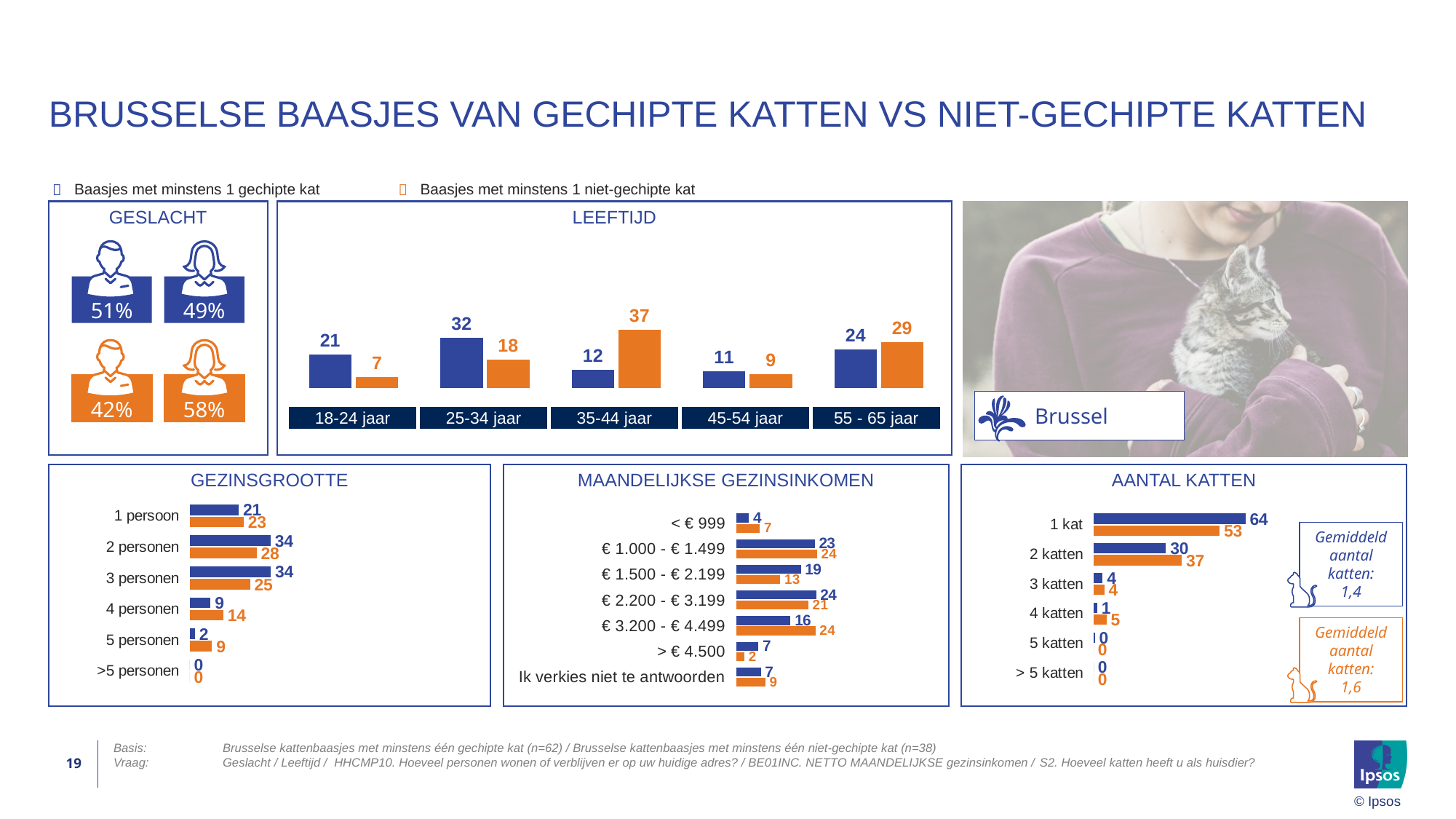
In the AANTAL KATTEN chart, what is the difference between the two series for 2 katten? 7 In the MAANDELIJKSE GEZINSINKOMEN chart, which is larger for > € 4.500: Baasjes met minstens 1 gechipte kat or Baasjes met minstens 1 niet-gechipte kat? Baasjes met minstens 1 gechipte kat In the MAANDELIJKSE GEZINSINKOMEN chart, what is the value for € 1.500 - € 2.199 for Baasjes met minstens 1 gechipte kat? 19 How many series does the legend at the top of the slide list? 2 In the GEZINSGROOTTE chart, which category has the lowest value for Baasjes met minstens 1 gechipte kat? >5 personen In the LEEFTIJD chart, how many age groups are shown? 5 What type of chart is the LEEFTIJD chart? Bar chart In the LEEFTIJD chart, what is the difference between the two series for 18-24 jaar? 14 In the LEEFTIJD chart, what is the value for 35-44 jaar for Baasjes met minstens 1 niet-gechipte kat? 37 In the LEEFTIJD chart, which age group has the highest value for Baasjes met minstens 1 gechipte kat? 25-34 jaar In the GEZINSGROOTTE chart, what is the value for 4 personen for Baasjes met minstens 1 niet-gechipte kat? 14 In the AANTAL KATTEN chart, what is the value for 1 kat for Baasjes met minstens 1 gechipte kat? 64